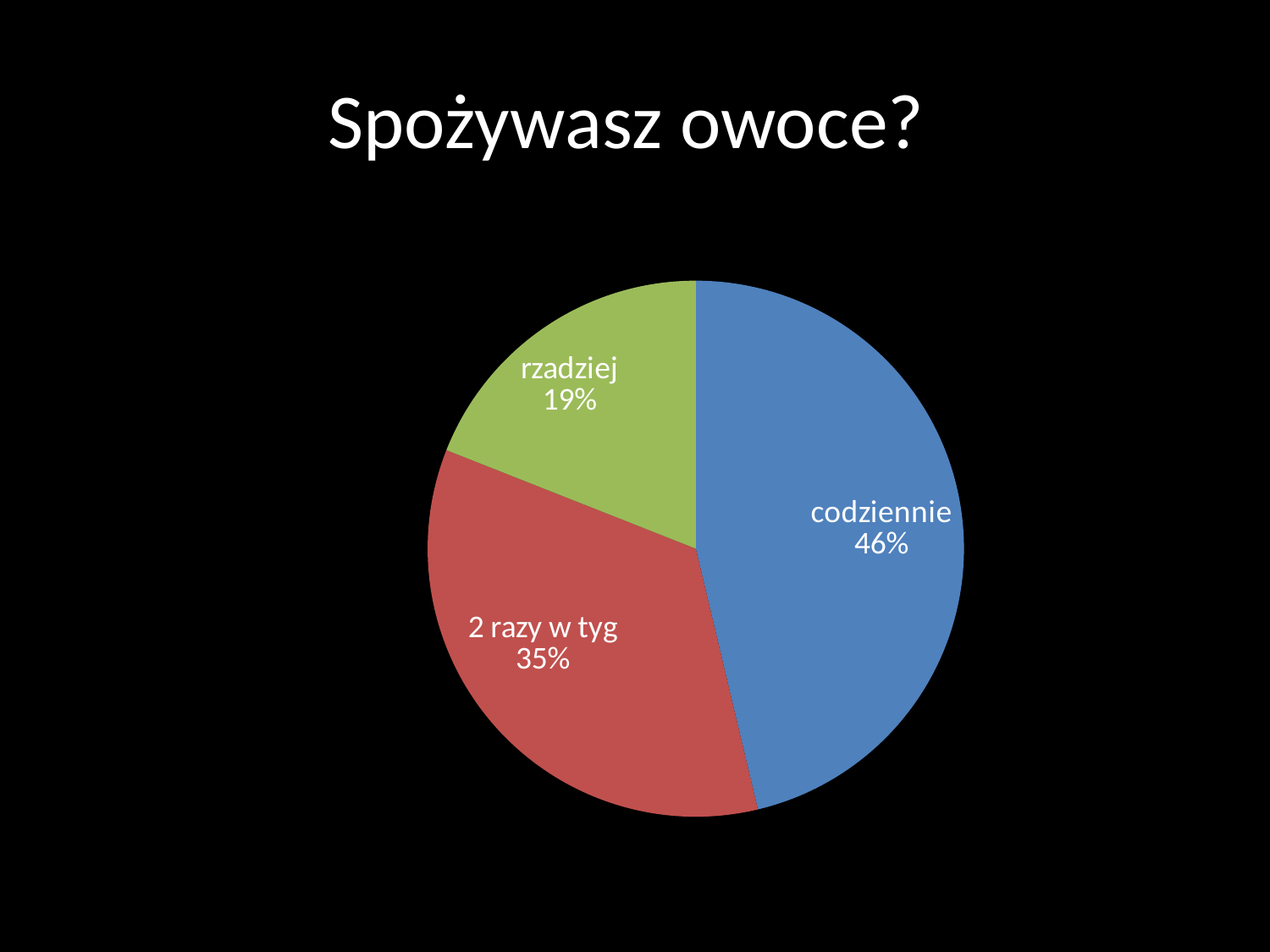
What share of the pie is labelled "rzadziej"? 19% Which slice of the pie is the smallest? rzadziej Which is larger, the share for "2 razy w tyg" or the share for "rzadziej"? 2 razy w tyg What kind of chart is shown on the slide? pie chart How many slices does the pie chart have? 3 Which slice of the pie is the largest? codziennie What is the difference in percentage points between "2 razy w tyg" and "rzadziej"? 16 What is the title of the chart? Spożywasz owoce? What is the difference in percentage points between "codziennie" and "2 razy w tyg"? 11 What share of the pie is labelled "codziennie"? 46% What share of the pie is labelled "2 razy w tyg"? 35% What colour is the slice labelled "rzadziej"? green